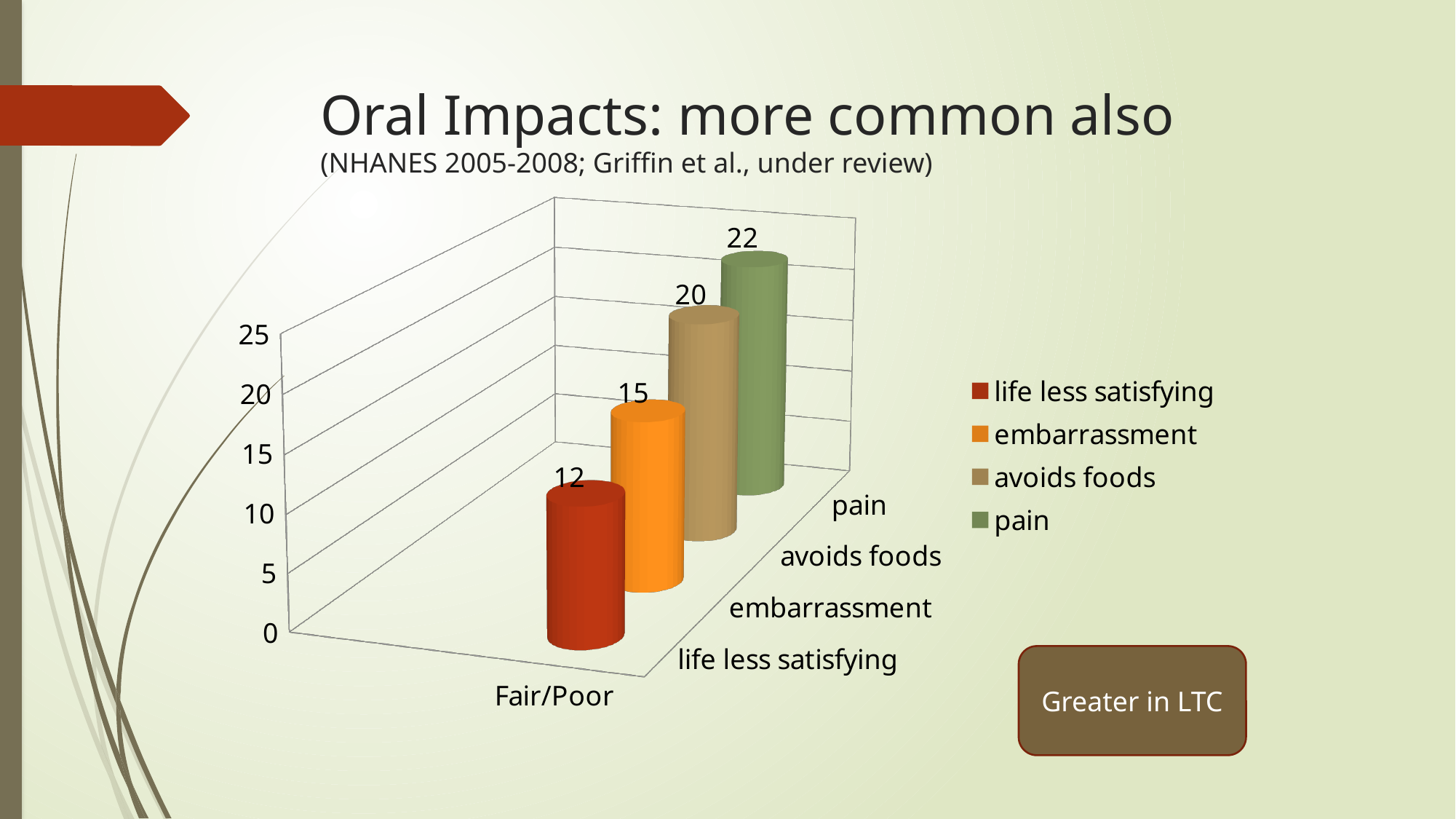
What kind of chart is shown on the slide? bar chart How many series does the legend list? 4 Is the value for avoids foods greater or less than 15? greater What is the difference between the values for pain and life less satisfying? 10 What is the value for embarrassment? 15 Which series has the lowest value? life less satisfying What is the value for avoids foods? 20 Which is larger, the value for avoids foods or the value for embarrassment? avoids foods What is the category label shown on the x axis? Fair/Poor What is the value for pain? 22 What is the value for life less satisfying? 12 Which series has the highest value? pain